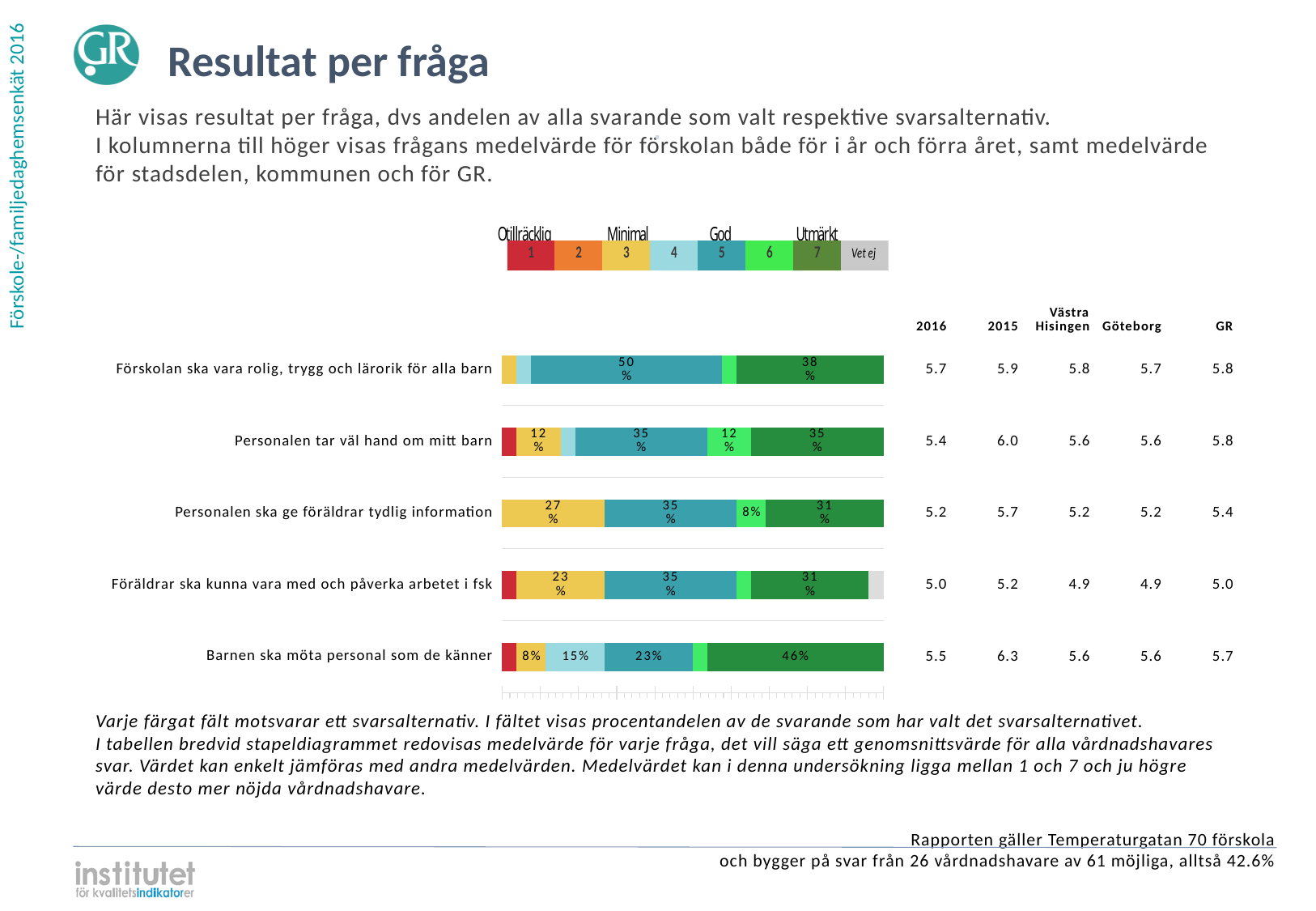
What is the 2016 mean value for 'Personalen tar väl hand om mitt barn'? 5.4 What is the 2015 mean value for 'Barnen ska möta personal som de känner'? 6.3 What percentage chose answer 5 (teal) for 'Förskolan ska vara rolig, trygg och lärorik för alla barn'? 50% Which question has the highest 2016 mean value? Förskolan ska vara rolig, trygg och lärorik för alla barn By how much did the mean for 'Barnen ska möta personal som de känner' fall from 2015 to 2016? 0.8 What kind of chart is used to show the results per question on this slide? Stacked horizontal bar chart Which question has the lowest 2016 mean value? Föräldrar ska kunna vara med och påverka arbetet i fsk What colour is used for the 'Vet ej' answer option in the legend? Grey How many questions (bars) are shown in the chart? 5 Which has the larger share of answer 3 (yellow): 'Personalen ska ge föräldrar tydlig information' or 'Föräldrar ska kunna vara med och påverka arbetet i fsk'? Personalen ska ge föräldrar tydlig information What percentage of respondents chose answer 7 (Utmärkt, dark green) for 'Barnen ska möta personal som de känner'? 46% What is the GR mean value for 'Personalen ska ge föräldrar tydlig information'? 5.4